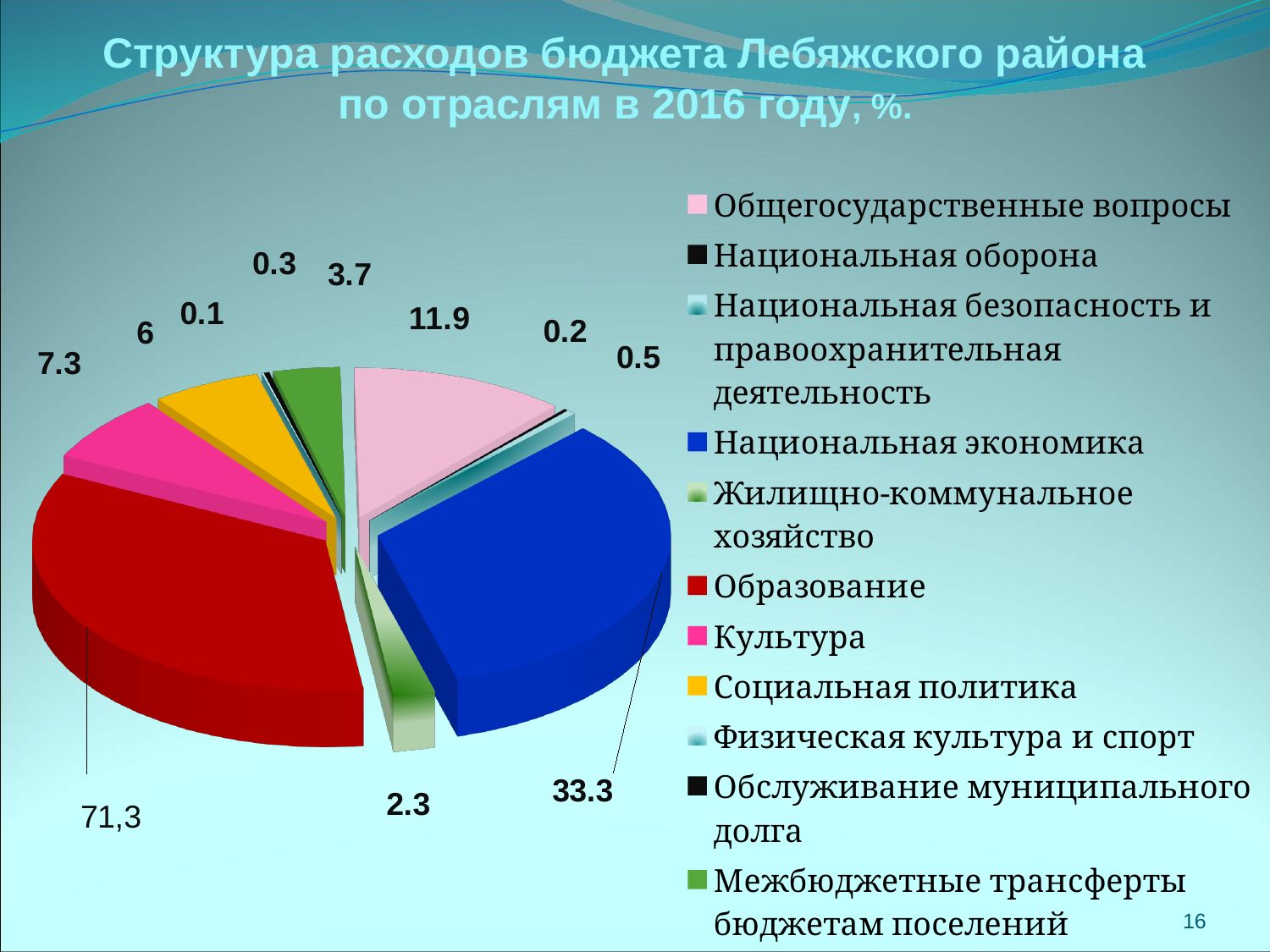
What is the value shown for Культура? 7.3 What is the value shown for Общегосударственные вопросы? 11.9 Which category has the smallest value in the chart? Физическая культура и спорт What is the value shown for Межбюджетные трансферты бюджетам поселений? 3.7 What is the value shown for Образование? 71,3 What type of chart is shown on the slide? pie chart Which category has the largest share of the pie? Образование Which is larger, the value for Культура or the value for Социальная политика? Культура What is the value shown for Национальная экономика? 33.3 What is the difference between the values for Национальная экономика and Общегосударственные вопросы? 21.4 How many categories does the legend list? 11 What is the value shown for Жилищно-коммунальное хозяйство? 2.3